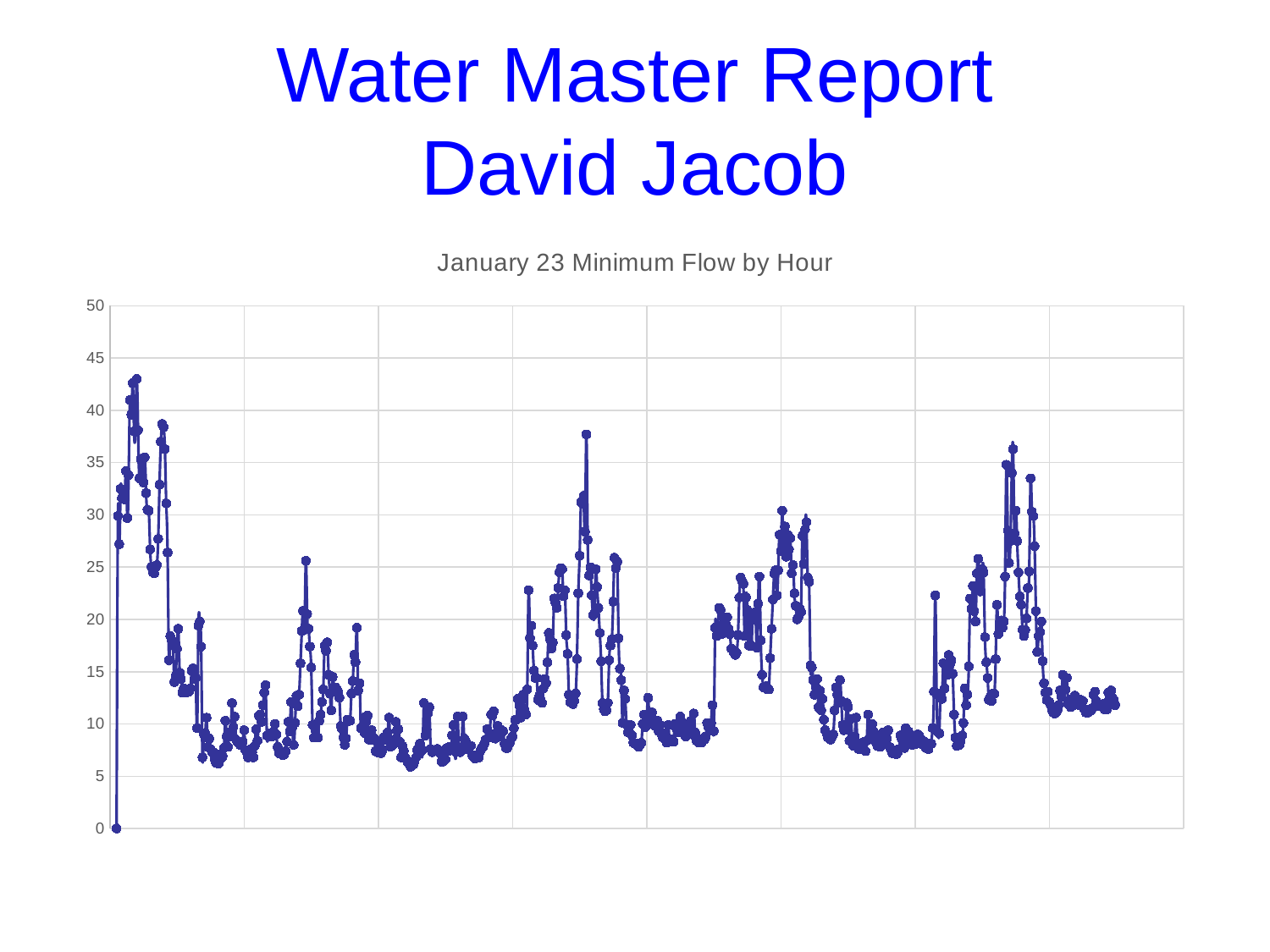
What kind of chart is shown on the slide? line chart Is the highest point on the line greater or less than 40? greater What is the title of the chart? January 23 Minimum Flow by Hour Is the first point on the left end of the line greater or less than 5? less What is the highest value shown on the vertical axis? 50 How many data series are plotted on the chart? 1 Is the lowest point on the line greater or less than 5? less